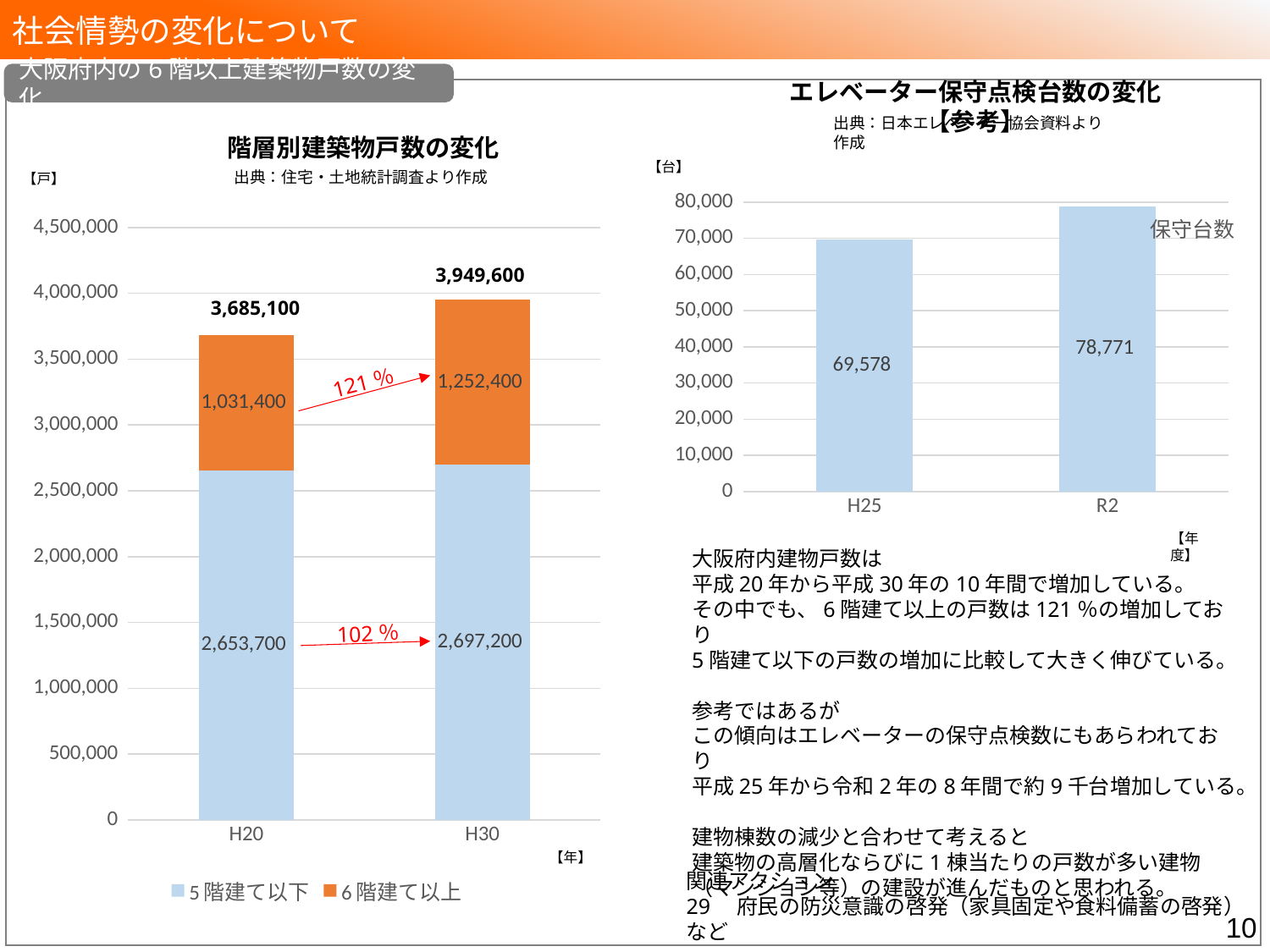
In the chart titled 階層別建築物戸数の変化, what is the value for 6階建て以上 in H30? 1,252,400 In the chart titled エレベーター保守点検台数の変化, what is the value for R2? 78,771 In the chart titled エレベーター保守点検台数の変化, what is the value for H25? 69,578 In the chart titled 階層別建築物戸数の変化, what is the total of the stacked bar for H30? 3,949,600 In the chart titled 階層別建築物戸数の変化, which colour represents 6階建て以上? Orange In the chart titled 階層別建築物戸数の変化, how many series does the legend list? 2 In the chart titled 階層別建築物戸数の変化, what is the difference between the 6階建て以上 values for H30 and H20? 221,000 In the chart titled 階層別建築物戸数の変化, what kind of chart is it? Stacked bar chart In the chart titled エレベーター保守点検台数の変化, what is the difference between the R2 and H25 values? 9,193 In the chart titled 階層別建築物戸数の変化, what is the value for 5階建て以下 in H20? 2,653,700 In the chart titled エレベーター保守点検台数の変化, how many categories are shown on the x axis? 2 In the chart titled 階層別建築物戸数の変化, what is the total of the stacked bar for H20? 3,685,100